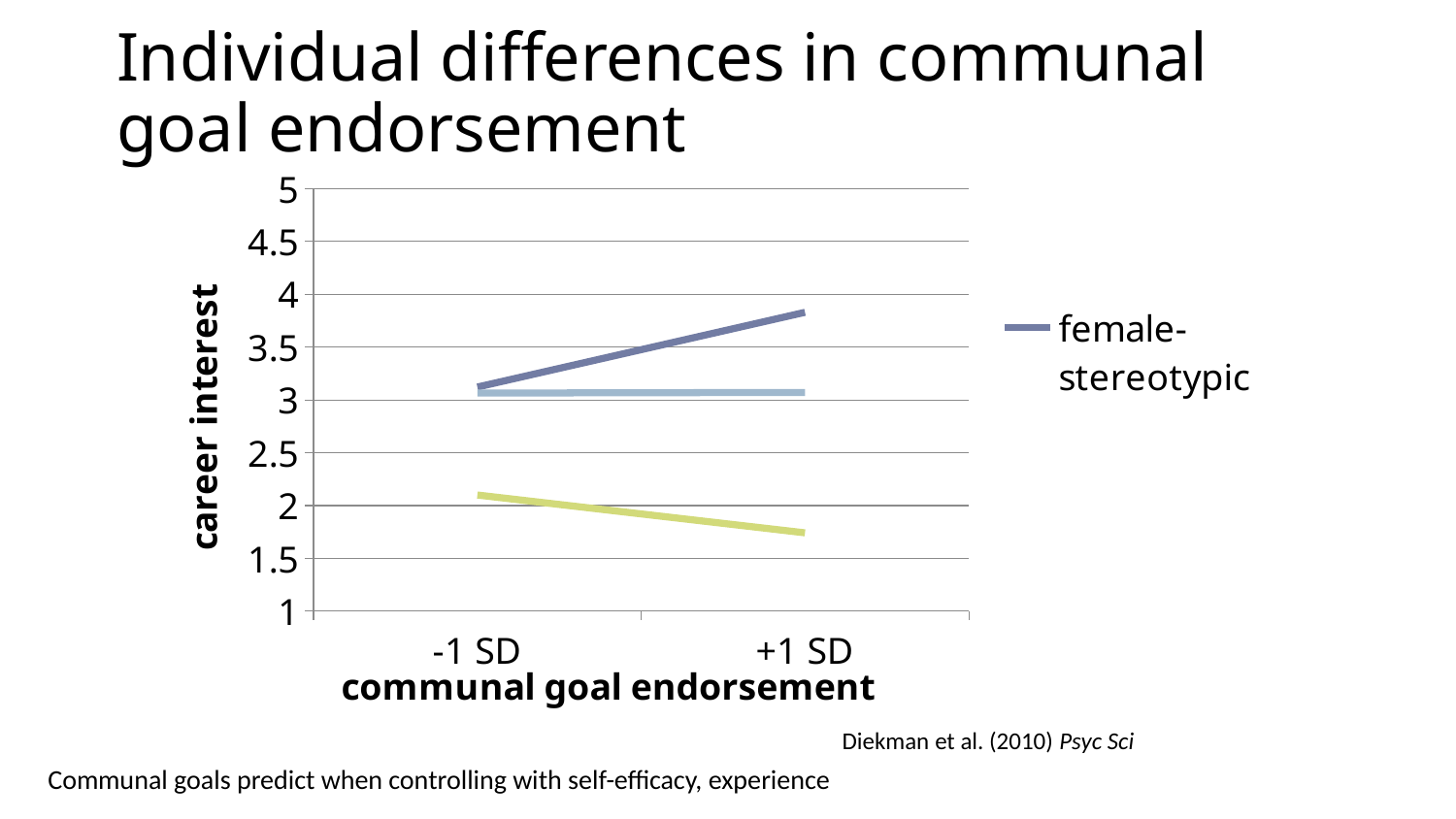
How many categories are shown on the x axis of the chart? 2 What kind of chart is shown on the slide? line chart What is the label of the x axis of the chart? communal goal endorsement For the female-stereotypic series, is the value larger at -1 SD or at +1 SD? +1 SD Does the female-stereotypic line rise or fall from -1 SD to +1 SD? rise How many series does the chart legend list? 1 Is the value for female-stereotypic at +1 SD greater or less than 3.5? greater Is the value for female-stereotypic at -1 SD greater or less than 2.5? greater What is the series name listed in the chart legend? female-stereotypic Is the value for female-stereotypic at +1 SD greater or less than 4? less